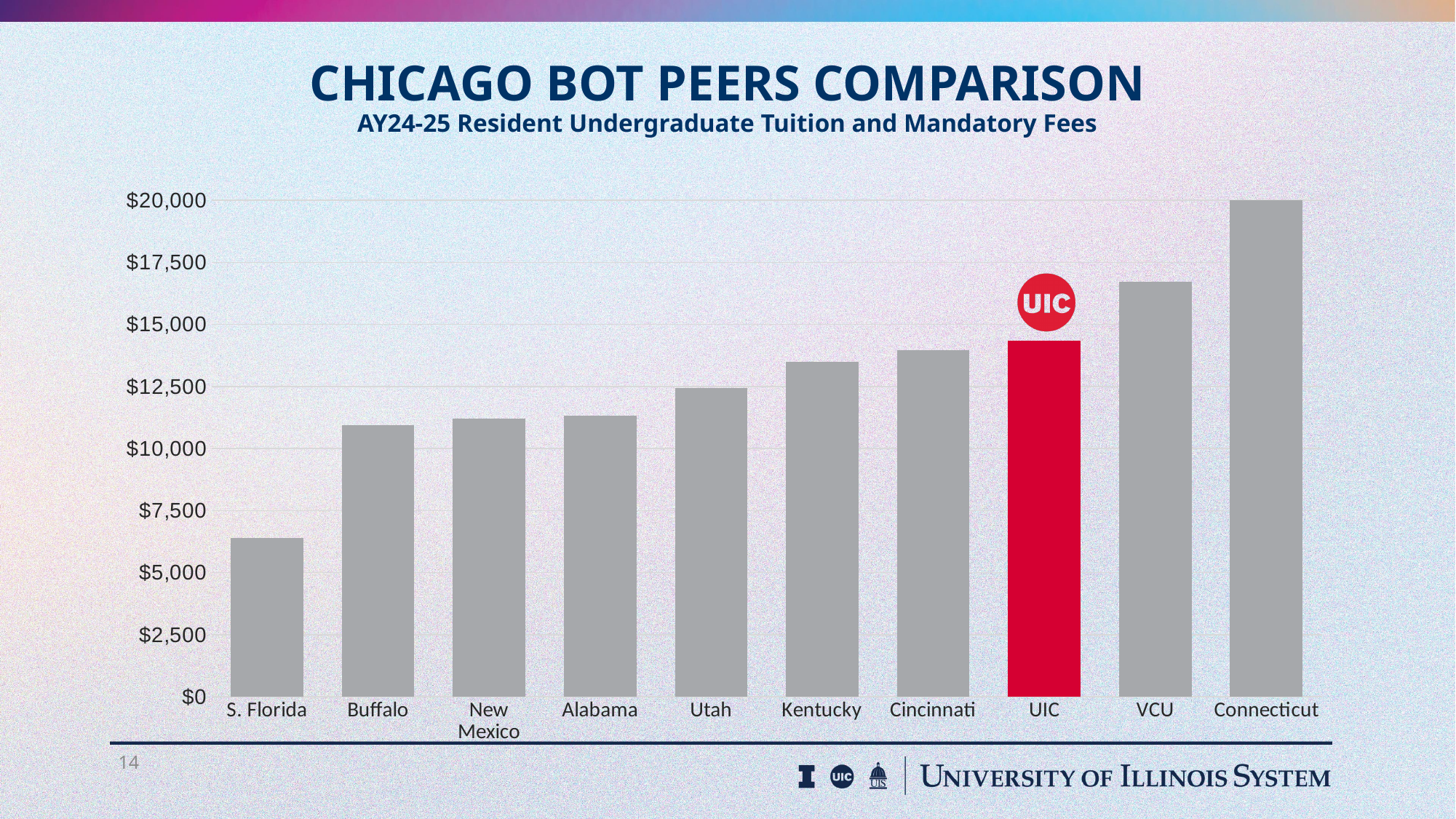
Which institution has the lowest resident undergraduate tuition and mandatory fees? S. Florida Which bar is highlighted in red on the chart? UIC Is the value for VCU greater or less than $15,000? greater What kind of chart is shown on the slide? bar chart Is the value for Kentucky greater or less than $12,500? greater Is the value for S. Florida greater or less than $7,500? less Which is larger, the value for VCU or the value for UIC? VCU Do the values rise or fall moving from left to right along the x axis? rise How many institutions are shown on the chart? 10 Which institution has the highest resident undergraduate tuition and mandatory fees? Connecticut